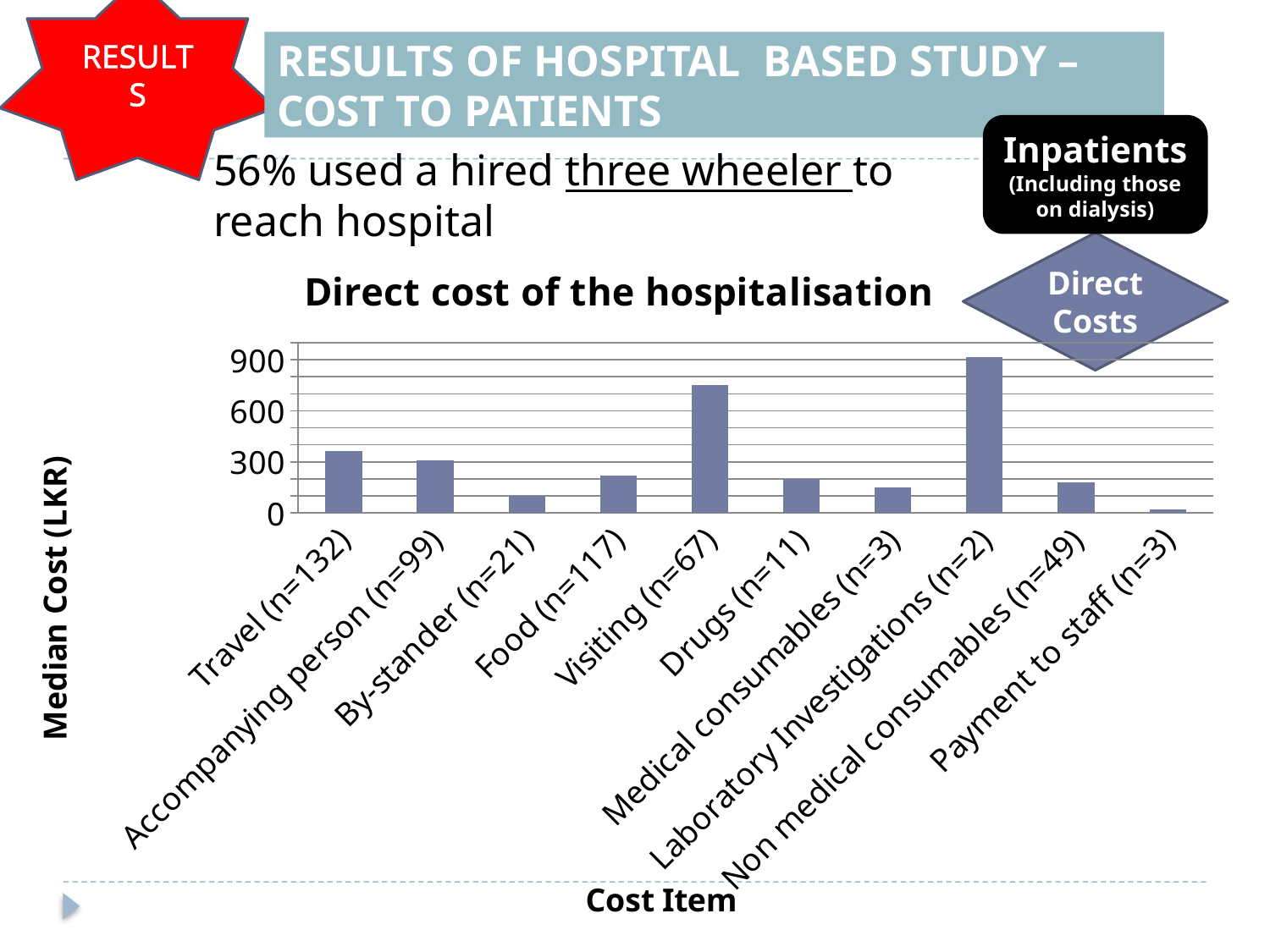
What kind of chart is shown under the title "Direct cost of the hospitalisation"? bar chart Which cost item has the highest median cost in the chart? Laboratory Investigations (n=2) Which has a higher median cost, Visiting (n=67) or Food (n=117)? Visiting (n=67) What is the label of the horizontal axis of the chart? Cost Item What is the label of the vertical axis of the chart? Median Cost (LKR) Which cost item has the lowest median cost in the chart? Payment to staff (n=3) Which has a higher median cost, Travel (n=132) or Drugs (n=11)? Travel (n=132) Is the median cost for Laboratory Investigations (n=2) greater or less than 600? greater Is the median cost for By-stander (n=21) greater or less than 300? less Is the median cost for Travel (n=132) greater or less than 300? greater How many cost items are plotted in the "Direct cost of the hospitalisation" chart? 10